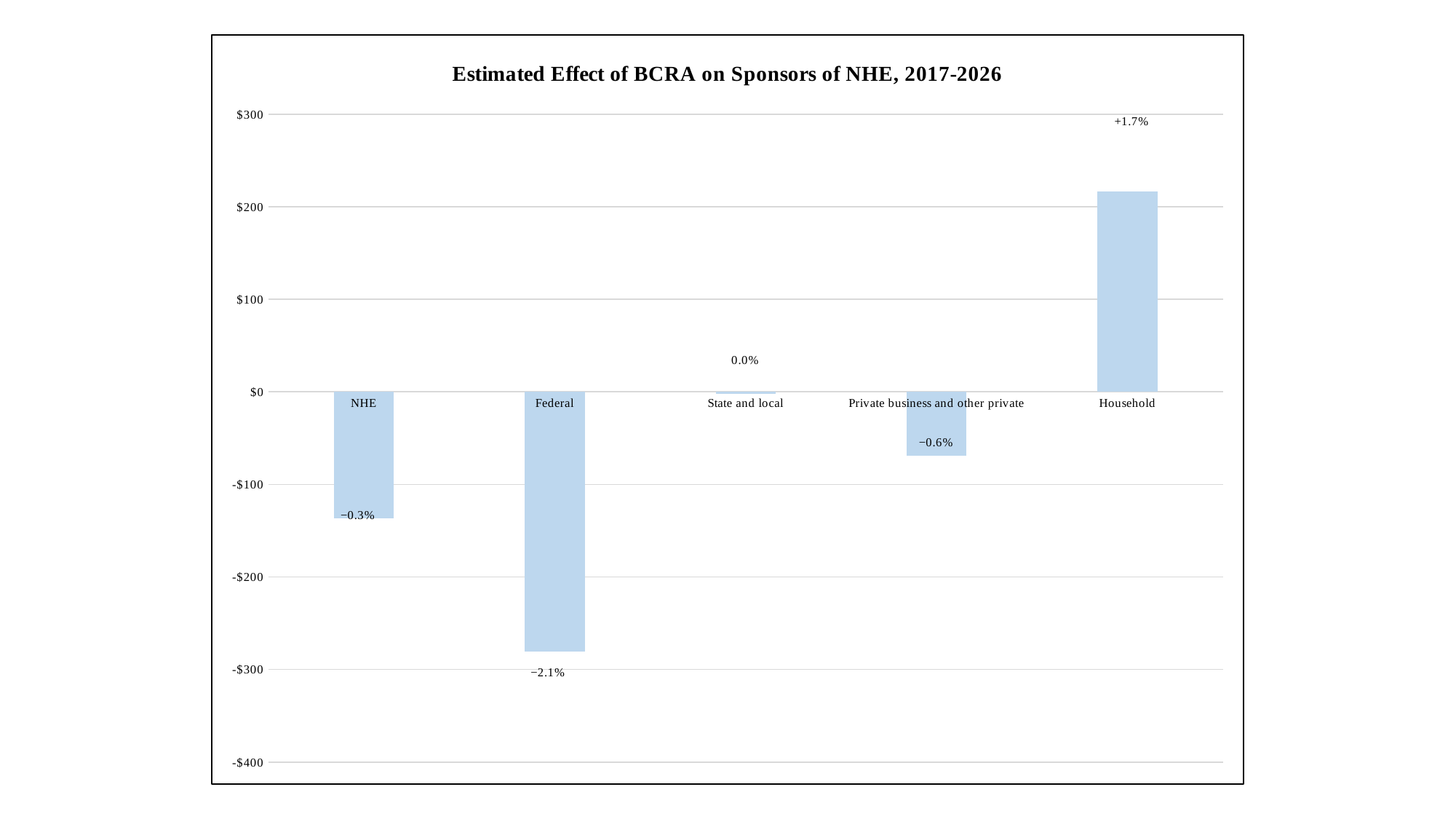
What percentage label is shown for the Private business and other private bar? −0.6% Is the value for Federal greater or less than -$200? less What percentage label is shown for the State and local bar? 0.0% What percentage label is shown for the Household bar? +1.7% How many categories are plotted on the x axis? 5 What is the title of the chart? Estimated Effect of BCRA on Sponsors of NHE, 2017-2026 What percentage label is shown for the Federal bar? −2.1% What percentage label is shown for the NHE bar? −0.3% What kind of chart is shown on the slide? bar chart Which category has the lowest bar? Federal Is the value for Household greater or less than $200? greater Which category has the highest bar? Household